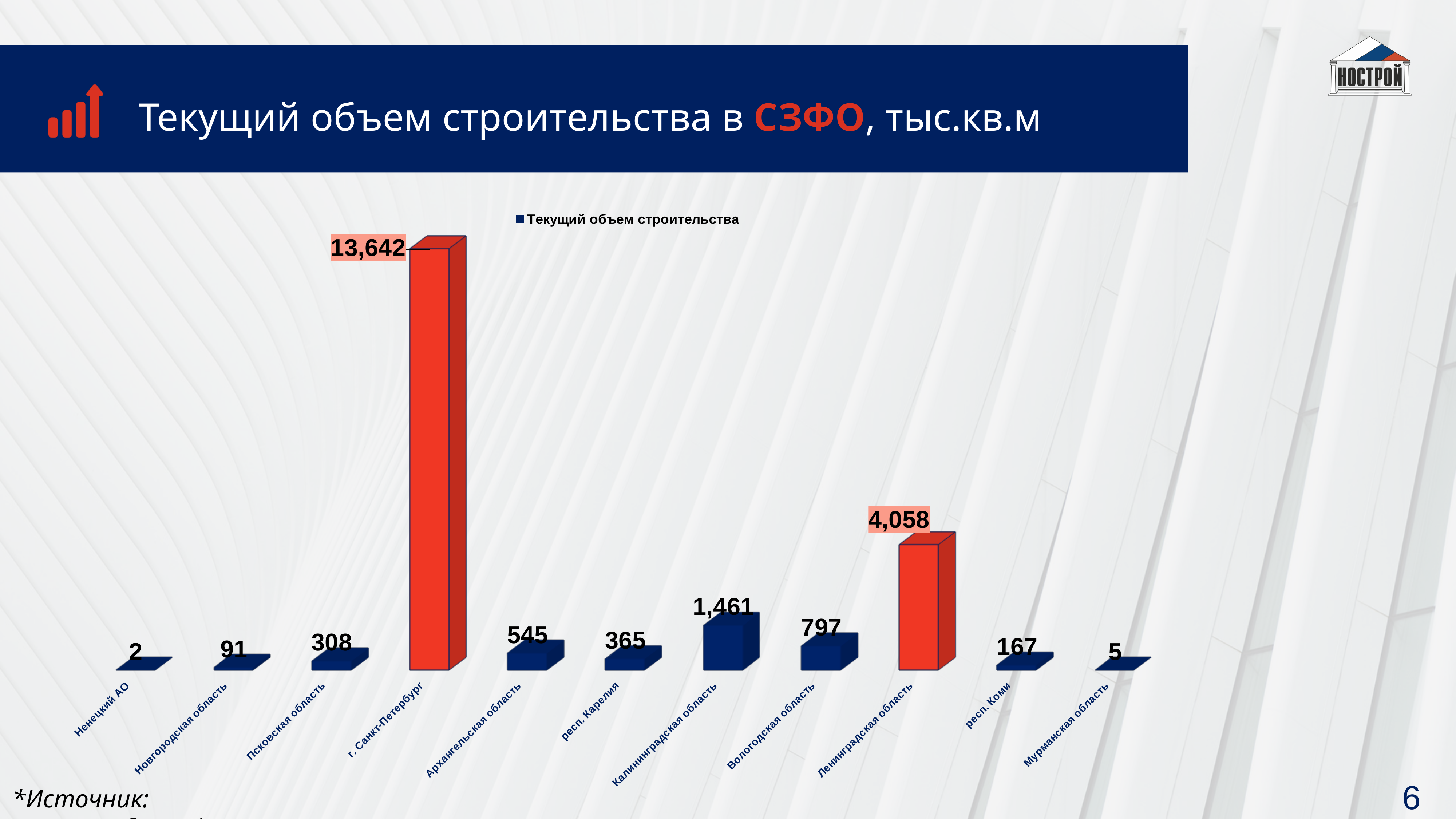
How many series does the legend list? 1 What is the legend entry of the chart? Текущий объем строительства How many regions are shown on the chart? 11 What kind of chart is shown on the slide? Bar chart Which region has the highest current construction volume? г. Санкт-Петербург What is the value for г. Санкт-Петербург? 13,642 What is the value for Калининградская область? 1,461 What is the value for респ. Коми? 167 What is the difference between the values for Вологодская область and Архангельская область? 252 Which is larger, the value for Псковская область or the value for респ. Карелия? респ. Карелия Which region has the lowest current construction volume? Ненецкий АО What is the value for Ленинградская область? 4,058